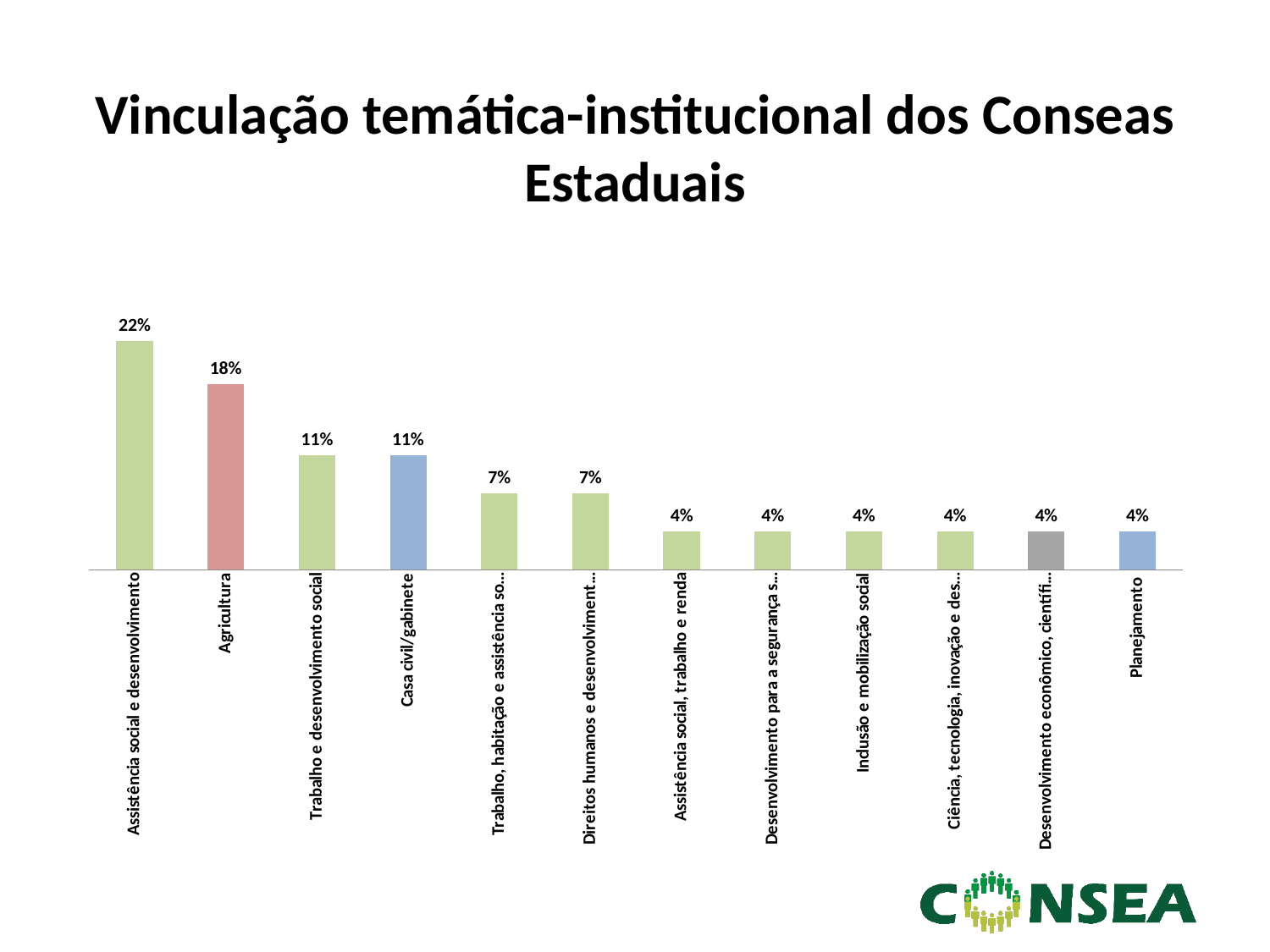
What kind of chart is shown on the slide? Bar chart Do the values rise or fall from left to right along the x axis? Fall Which category has the highest value? Assistência social e desenvolvimento What is the value for Agricultura? 18% How many categories are shown on the chart? 12 What is the lowest value shown on the chart? 4% What is the value for Assistência social, trabalho e renda? 4% What is the value for Planejamento? 4% What is the title of the slide? Vinculação temática-institucional dos Conseas Estaduais What is the difference between the values for Assistência social e desenvolvimento and Agricultura? 4% What is the value for Casa civil/gabinete? 11% Which is larger, the value for Agricultura or the value for Trabalho e desenvolvimento social? Agricultura